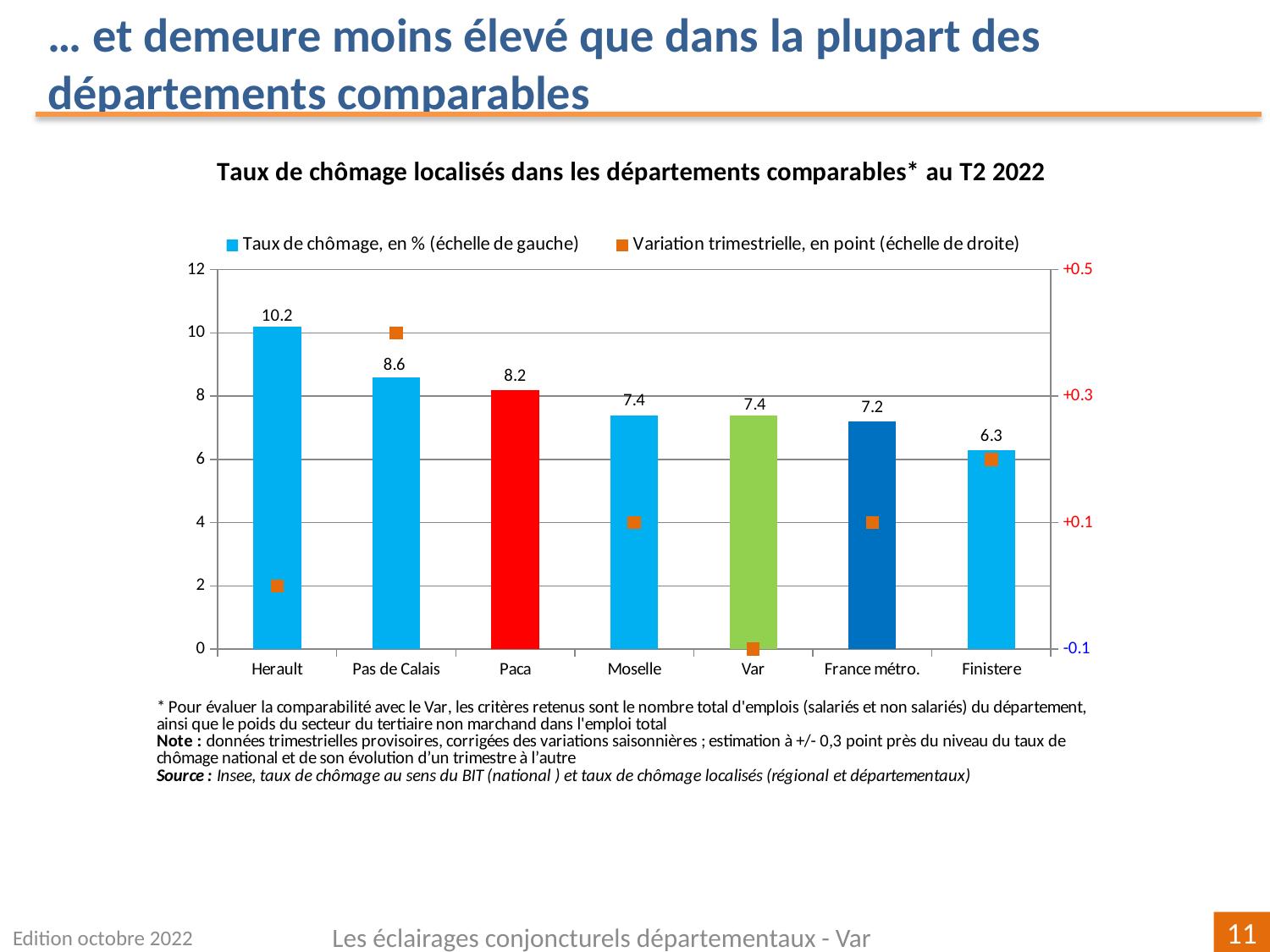
Is the quarterly variation (Variation trimestrielle) for Pas de Calais greater or less than +0.3? greater What type of chart is used to show the unemployment rates? Bar chart Which has a higher unemployment rate, Pas de Calais or Paca? Pas de Calais What is the unemployment rate (Taux de chômage, en %) for Herault? 10.2 What is the unemployment rate (Taux de chômage, en %) for Finistere? 6.3 Which department has the highest unemployment rate on the chart? Herault How many categories (departments/areas) are shown on the x axis? 7 What is the difference between the unemployment rates of Herault and Var? 2.8 What is the quarterly variation (Variation trimestrielle, en point) for Var, as read on the right-hand axis? -0.1 What is the unemployment rate (Taux de chômage, en %) for France métro.? 7.2 How many series does the legend list? 2 Which category has the lowest unemployment rate on the chart? Finistere